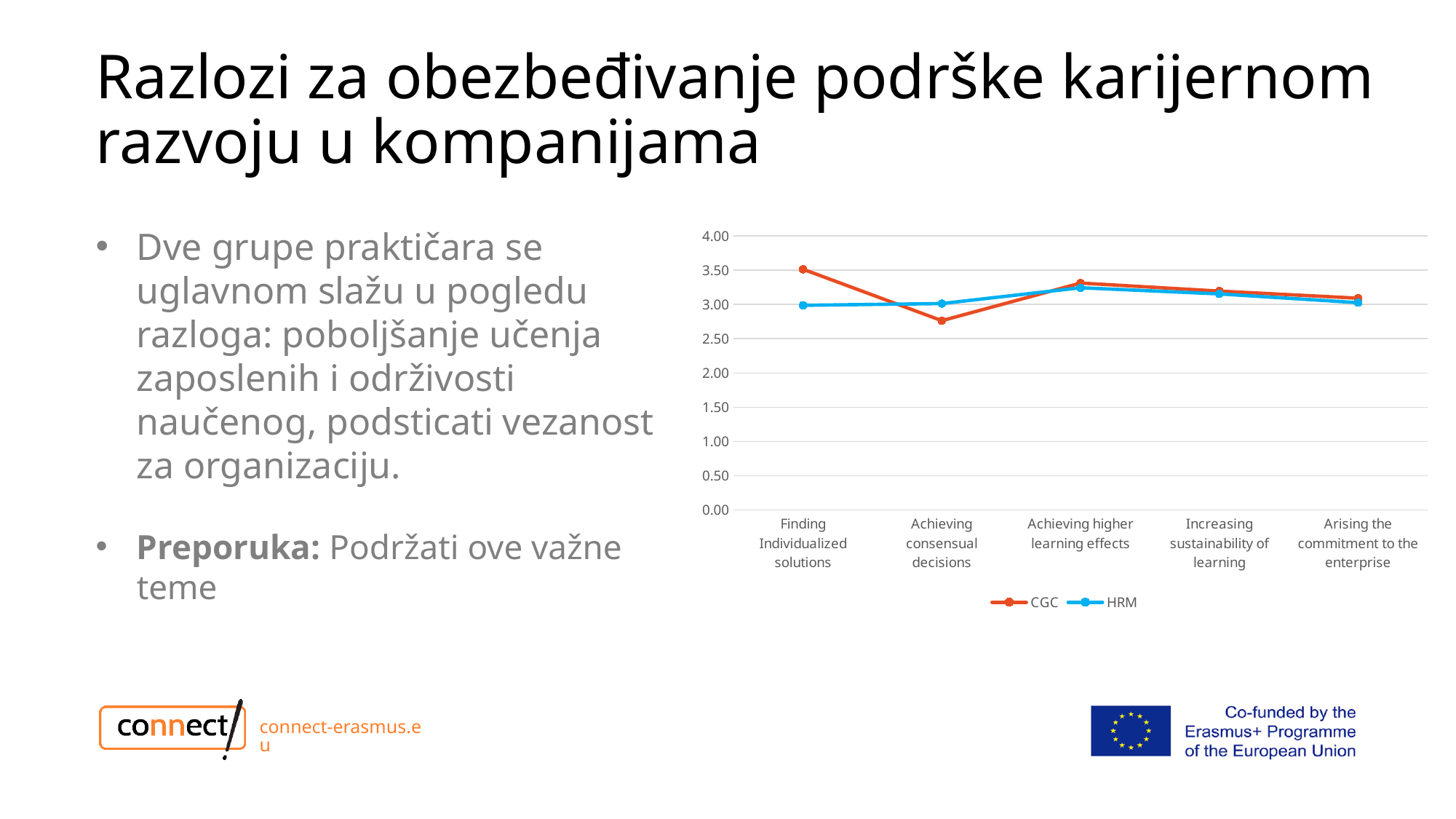
For which category is the CGC value highest? Finding Individualized solutions What colour is the CGC line in the chart? red For Finding Individualized solutions, which series has the higher value, CGC or HRM? CGC How many categories are shown along the x axis of the chart? 5 Is the CGC value for Finding Individualized solutions greater or less than 3.00? greater For Achieving consensual decisions, which series has the higher value, CGC or HRM? HRM Which series are listed in the chart's legend? CGC and HRM What kind of chart is shown on the slide? line chart For which category is the CGC value lowest? Achieving consensual decisions Is the HRM value for Achieving higher learning effects greater or less than 3.00? greater How many series does the chart's legend list? 2 Is the CGC value for Achieving consensual decisions greater or less than 3.00? less